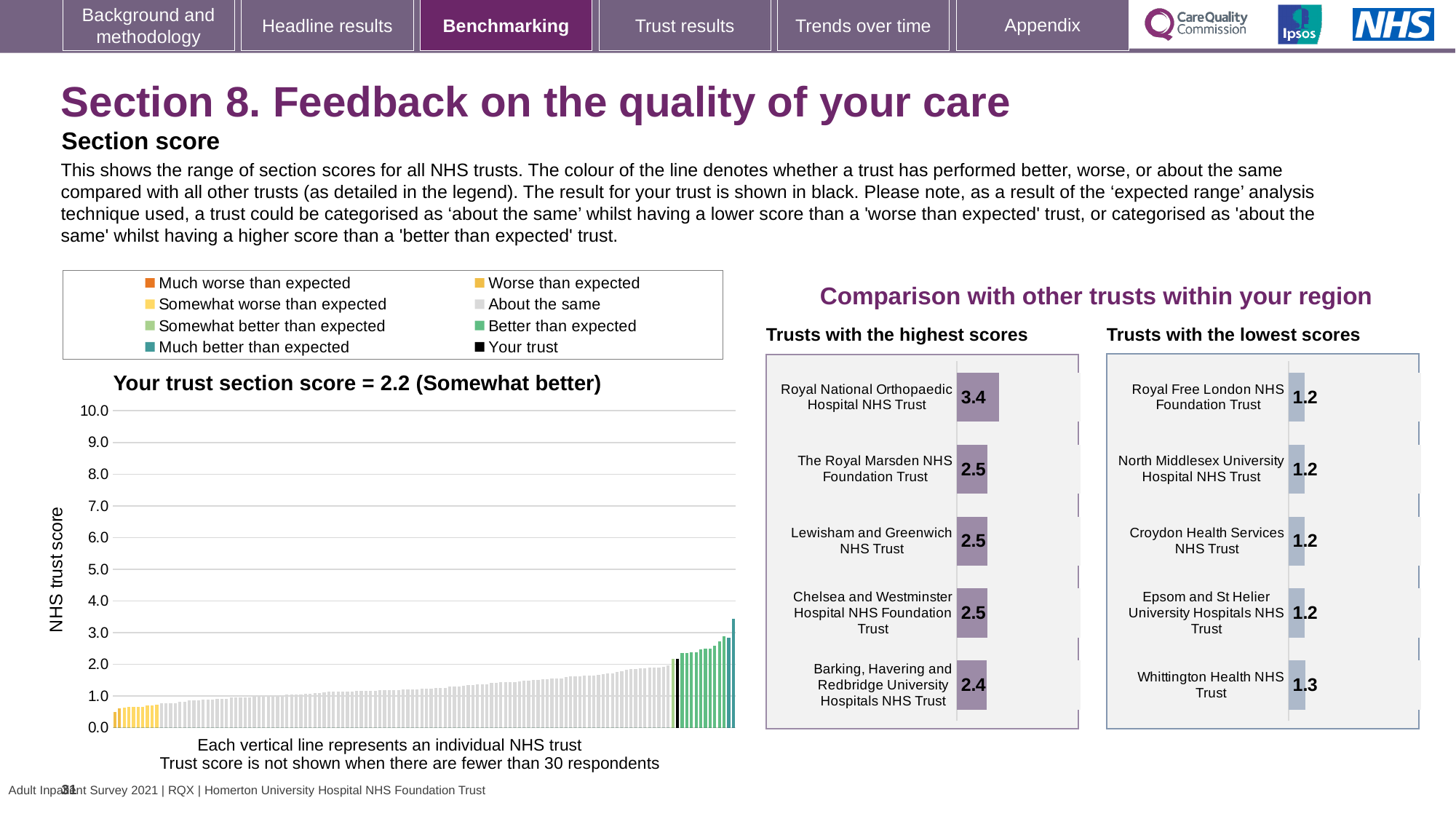
What is the y-axis label of the 'Your trust section score' chart? NHS trust score How many entries does the legend above the 'Your trust section score' chart list? 8 In the 'Trusts with the highest scores' chart, which trust has the lowest score? Barking, Havering and Redbridge University Hospitals NHS Trust In the 'Trusts with the highest scores' chart, what is the score for Royal National Orthopaedic Hospital NHS Trust? 3.4 In the 'Trusts with the lowest scores' chart, which trust has the highest score? Whittington Health NHS Trust In the 'Your trust section score' chart, is the highest trust score greater or less than 4.0? less In the 'Your trust section score' chart, do the trust scores rise or fall from left to right? rise In the 'Trusts with the highest scores' chart, what is the difference between the scores of Royal National Orthopaedic Hospital NHS Trust and Barking, Havering and Redbridge University Hospitals NHS Trust? 1.0 In the 'Your trust section score' chart, what is the section score for your trust? 2.2 What kind of chart is the 'Your trust section score' chart? bar chart How many trusts are shown in the 'Trusts with the lowest scores' chart? 5 In the 'Trusts with the lowest scores' chart, what is the score for Croydon Health Services NHS Trust? 1.2